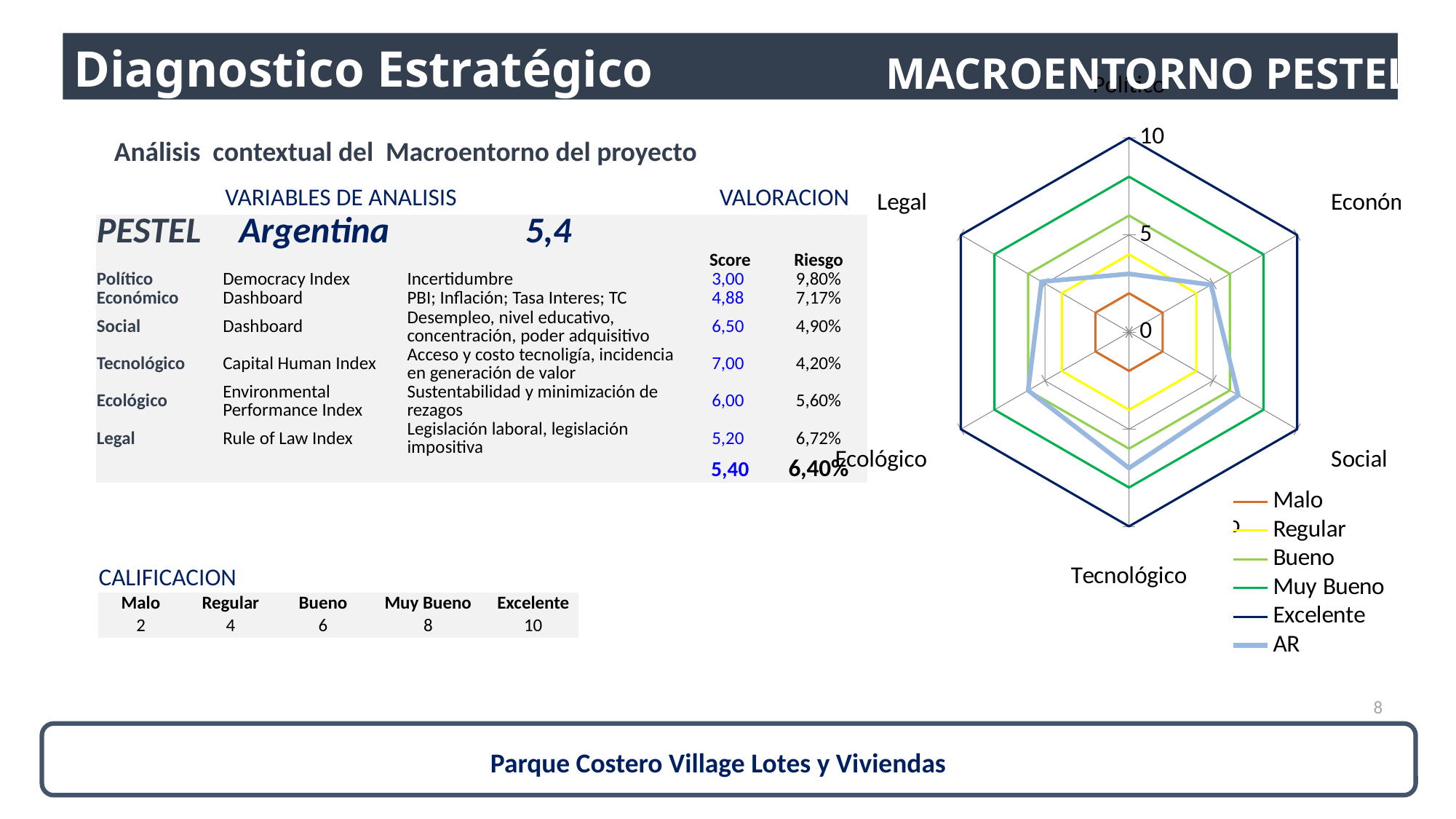
On the radar chart, is the AR value for Social greater or less than 5? greater On the radar chart, which is larger for the AR series: Político or Tecnológico? Tecnológico What kind of chart is shown on the right of the slide? radar chart How many series does the legend of the radar chart list? 6 On the radar chart, is the AR value for Tecnológico greater or less than 5? greater On the radar chart, is the AR value for Político greater or less than 5? less How many axes (categories) does the radar chart have? 6 On the radar chart, which is larger for the AR series: Político or Social? Social On the radar chart, what value does the Excelente series reach on the Político axis? 10 On the radar chart, which series forms the outermost hexagon? Excelente On the radar chart, which series forms the innermost hexagon? Malo On the radar chart, which category has the lowest value for the AR series? Político